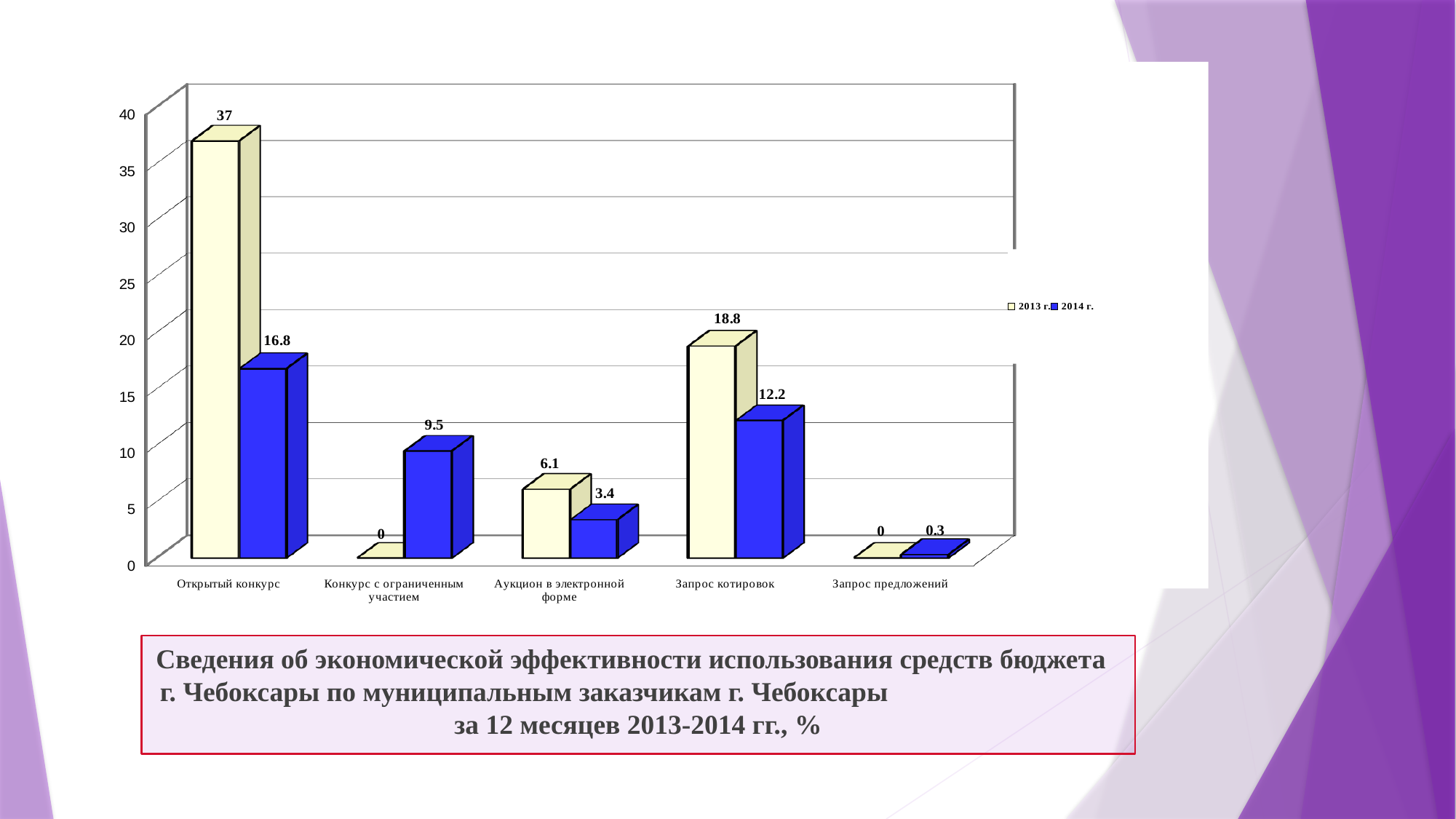
Which category has the highest value for 2013 г.? Открытый конкурс What is the difference between the 2013 г. and 2014 г. values for Открытый конкурс? 20.2 What is the value for 2014 г. for Конкурс с ограниченным участием? 9.5 How many series does the legend list? 2 What is the value for 2013 г. for Аукцион в электронной форме? 6.1 How many categories are shown on the x axis? 5 Which category has the lowest value for 2014 г.? Запрос предложений What kind of chart is shown on the slide? Bar chart What is the value for 2014 г. for Запрос котировок? 12.2 Is the 2013 г. value for Запрос котировок greater or less than 15? greater Which is larger for Запрос котировок: the 2013 г. value or the 2014 г. value? 2013 г. What is the value for 2013 г. for Открытый конкурс? 37